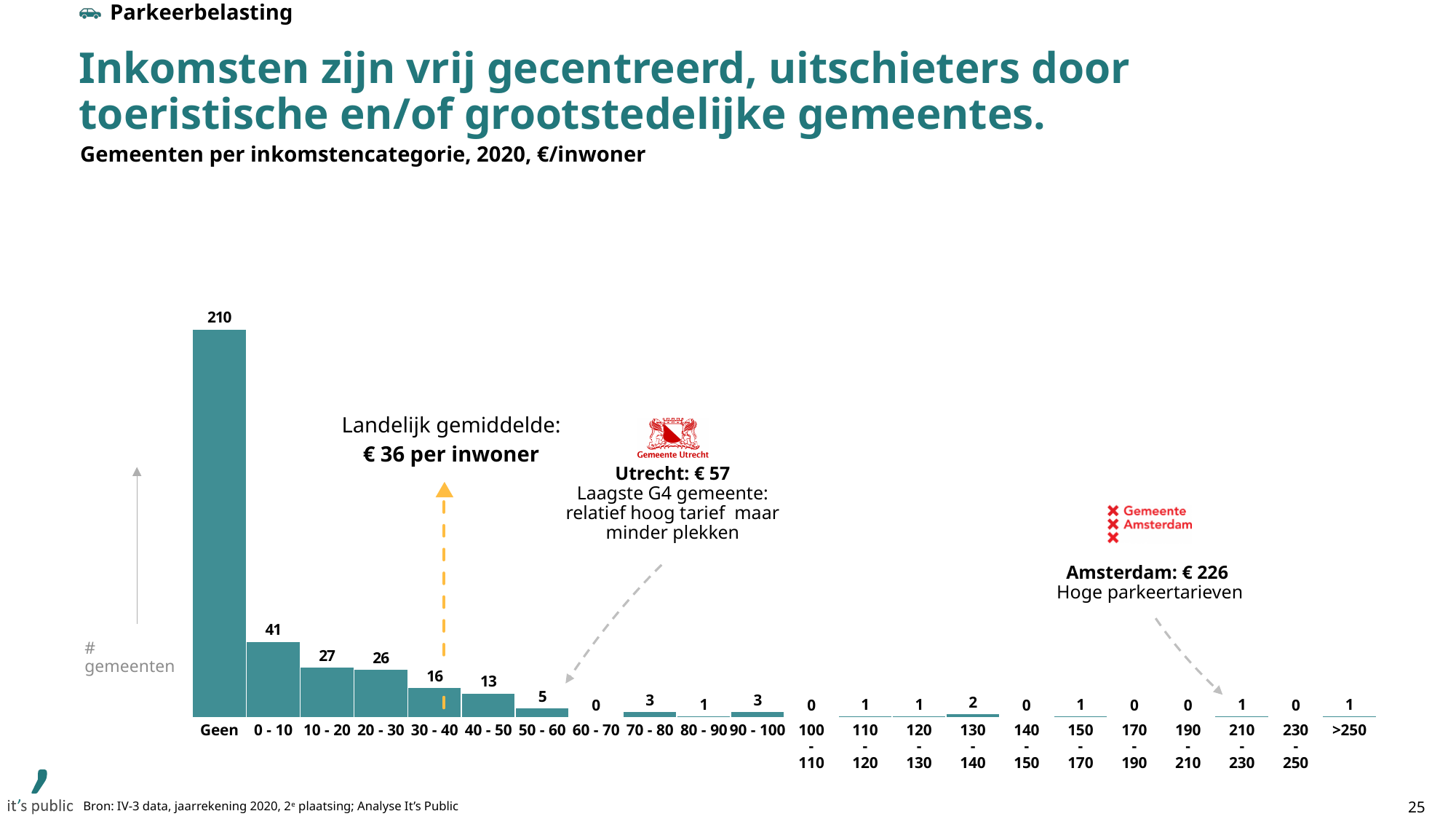
How many income categories are shown on the x axis? 22 Which is larger, the value for '40 - 50' or the value for '50 - 60'? 40 - 50 What is the difference between the '0 - 10' and '10 - 20' categories? 14 What is the difference between the 'Geen' category and the '0 - 10' category? 169 What type of chart is shown on the slide? Bar chart How many municipalities fall in the '30 - 40' income category? 16 What is the lowest value shown on the chart? 0 What is the value for the '0 - 10' category? 41 Which category has the highest number of municipalities? Geen How many municipalities are in the 'Geen' category? 210 What is the value shown for the '130 - 140' category? 2 What national average (Landelijk gemiddelde) is annotated on the chart? € 36 per inwoner